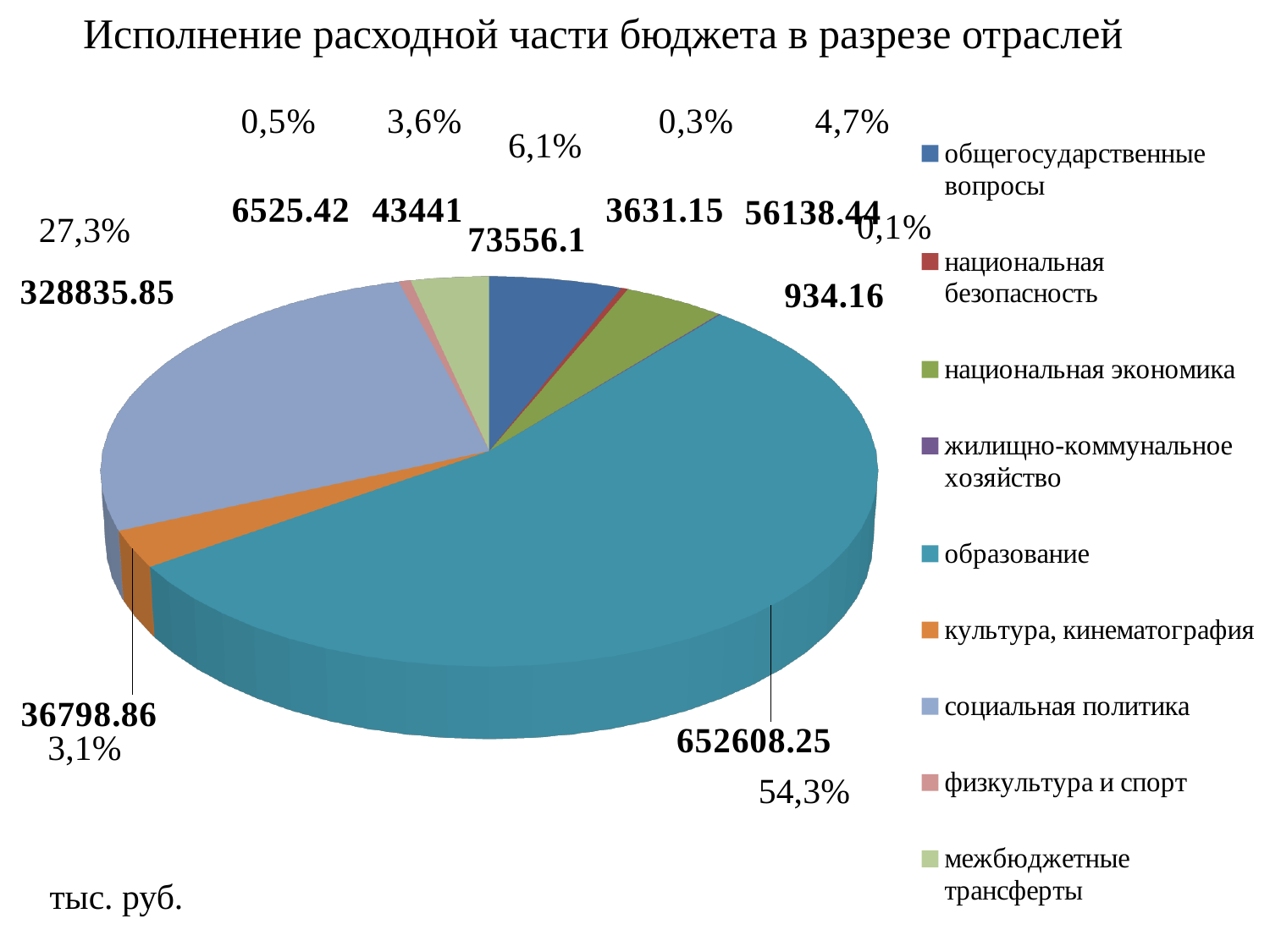
In what units are the values on the chart given? тыс. руб. What kind of chart is shown on the slide? pie chart What share of the pie does социальная политика take? 27,3% Which category has the largest slice of the pie? образование What share of the pie does образование take? 54,3% Which is larger, the slice for образование or the slice for социальная политика? образование What is the value shown for образование? 652608.25 What is the difference between the values for образование and социальная политика? 323772.4 What is the title of the chart? Исполнение расходной части бюджета в разрезе отраслей How many categories does the legend list? 9 What is the value shown for социальная политика? 328835.85 What is the value shown for культура, кинематография? 36798.86